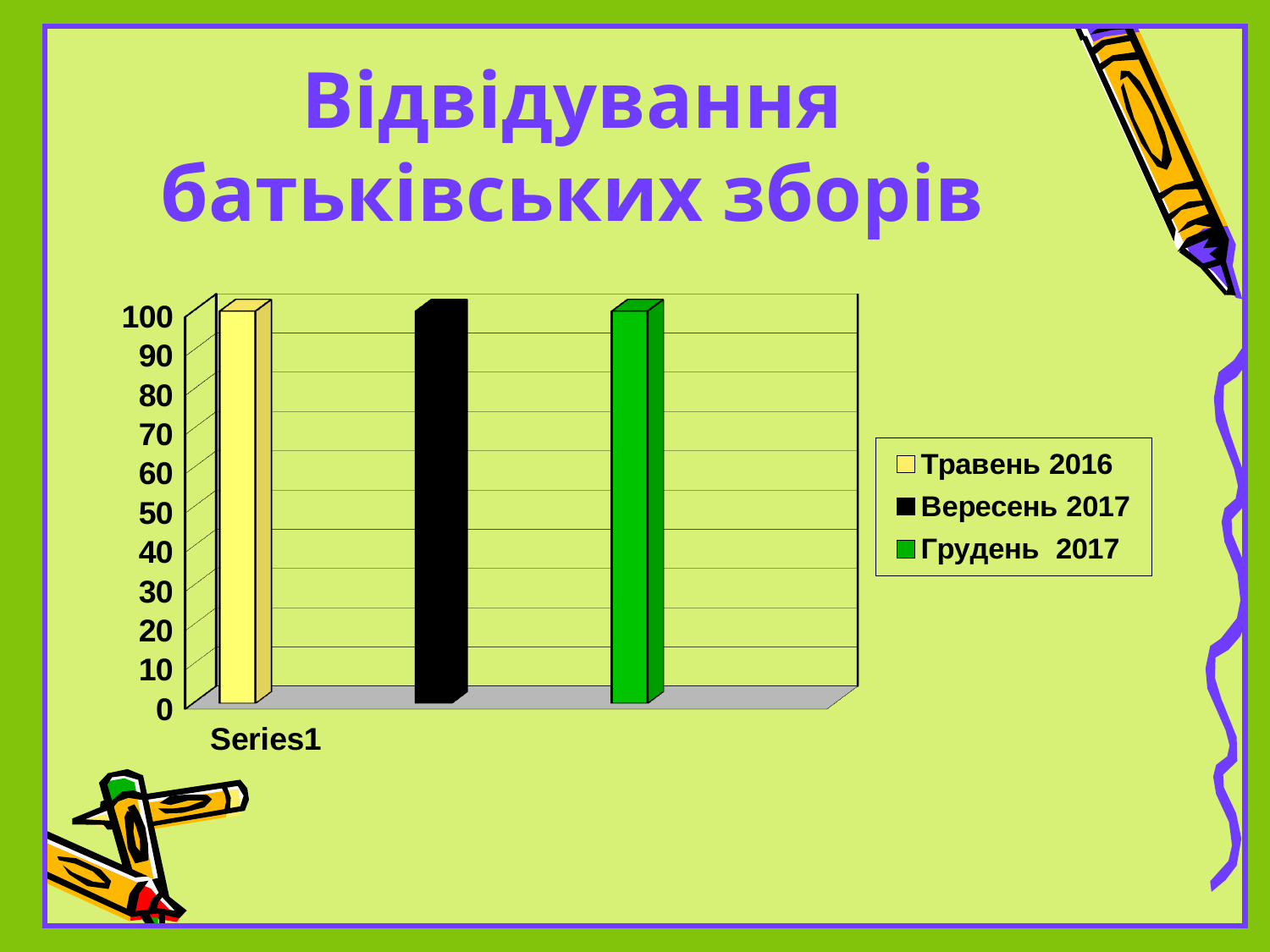
What is the title of the chart? Відвідування батьківських зборів How many categories are shown on the x axis? 1 What is the highest value shown on the y axis? 100 Which series is shown in black? Вересень 2017 Is the value for Вересень 2017 greater or less than 80? greater Is the value for Травень 2016 greater or less than 50? greater What kind of chart is shown on the slide? bar chart How many series does the legend list? 3 Is the value for Грудень 2017 greater or less than 60? greater